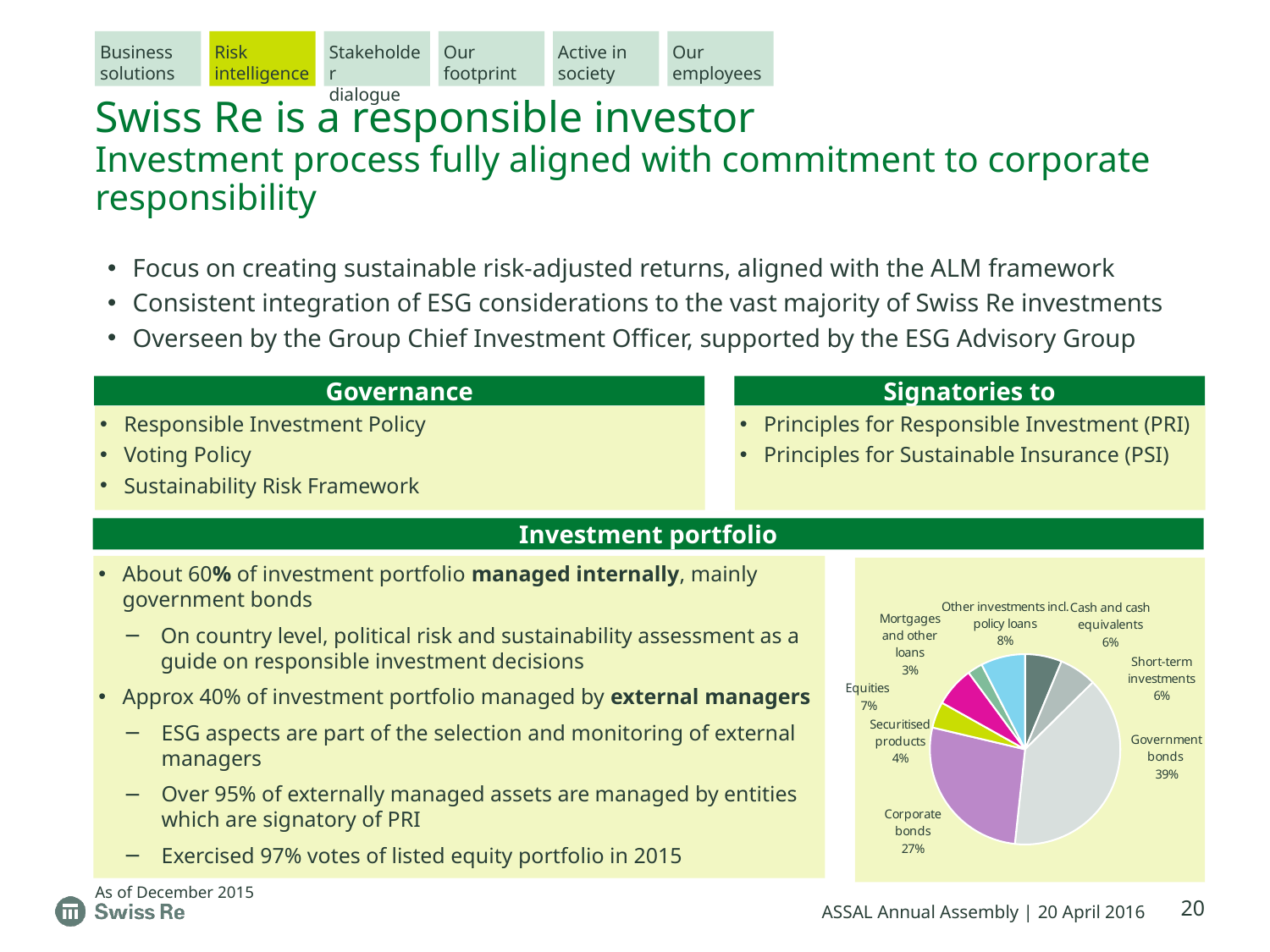
Which category has the largest share of the investment portfolio? Government bonds How many categories are shown in the investment portfolio pie chart? 8 Which category has the smallest share of the investment portfolio? Mortgages and other loans What is the combined share of Cash and cash equivalents and Short-term investments? 12% What share of the investment portfolio is Corporate bonds? 27% What is the difference in percentage points between Government bonds and Corporate bonds? 12 What share of the investment portfolio is Securitised products? 4% Which is larger, the share for Equities or the share for Cash and cash equivalents? Equities What kind of chart is used to show the investment portfolio? Pie chart What share of the investment portfolio is Other investments incl. policy loans? 8% What share of the investment portfolio is Government bonds? 39% What share of the investment portfolio is Equities? 7%